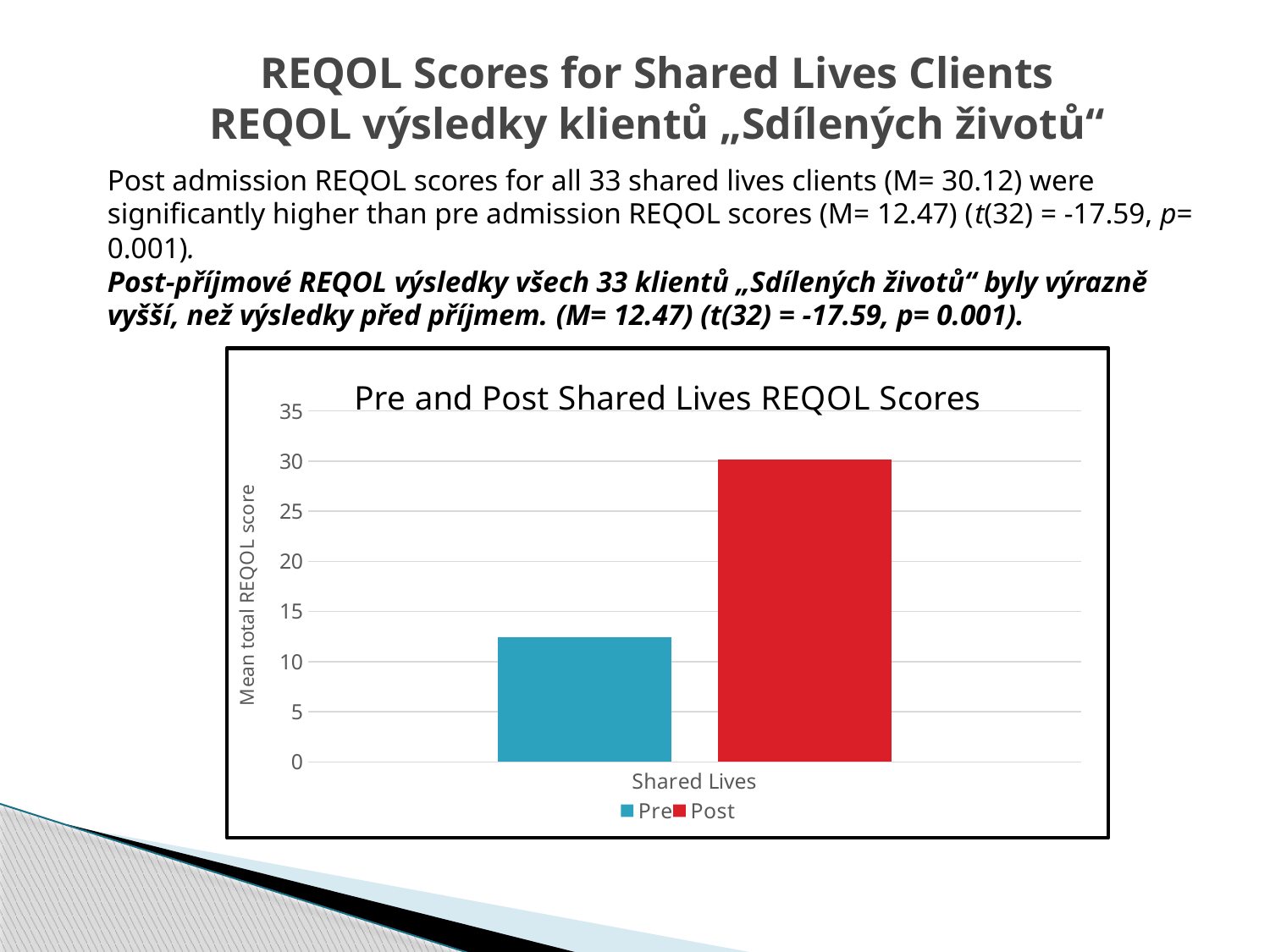
Which series has the lowest bar in the chart? Pre What is the label of the category on the x axis? Shared Lives Is the value for Post greater or less than 35? less Is the value for Post greater or less than 25? greater Is the value for Pre greater or less than 15? less What is the title of the chart? Pre and Post Shared Lives REQOL Scores Which series has the higher value in the chart, Pre or Post? Post What kind of chart is shown on the slide? bar chart How many categories are shown on the x axis of the chart? 1 How many series does the legend list in the chart? 2 What are the two series named in the chart legend? Pre and Post